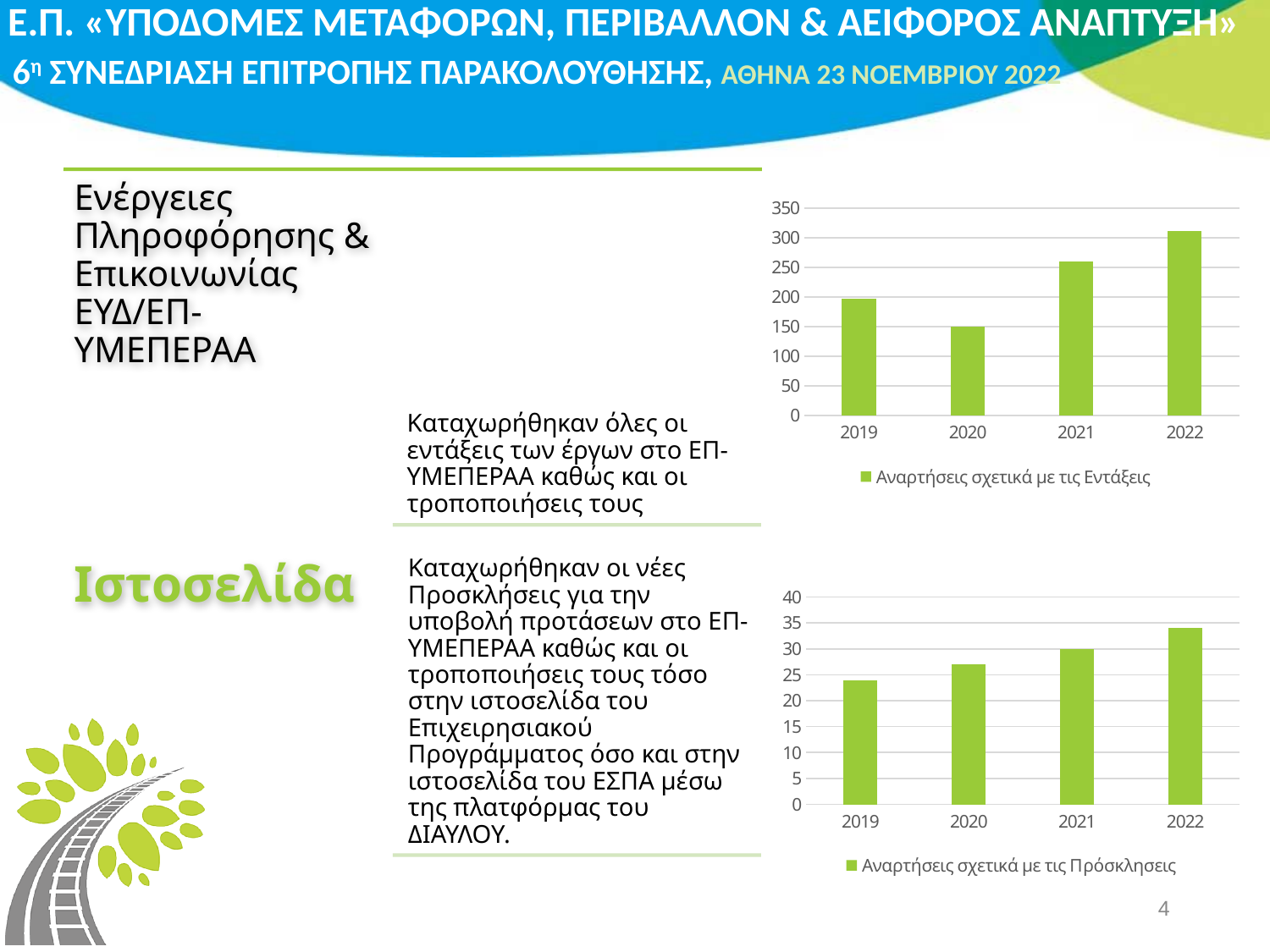
How many years are shown on the x axis of the top chart? 4 In the top chart, which year has the highest value? 2022 What series name does the legend of the top chart show? Αναρτήσεις σχετικά με τις Εντάξεις How many series does the legend of the bottom chart list? 1 In the top chart, which year has the lowest value? 2020 In the top chart, is the value for 2022 greater or less than 300? greater In the top chart, which is larger, the value for 2019 or the value for 2021? 2021 In the bottom chart, which year has the highest value? 2022 What kind of chart is the top chart on the slide? bar chart In the bottom chart, do the values rise or fall from 2019 to 2022? rise